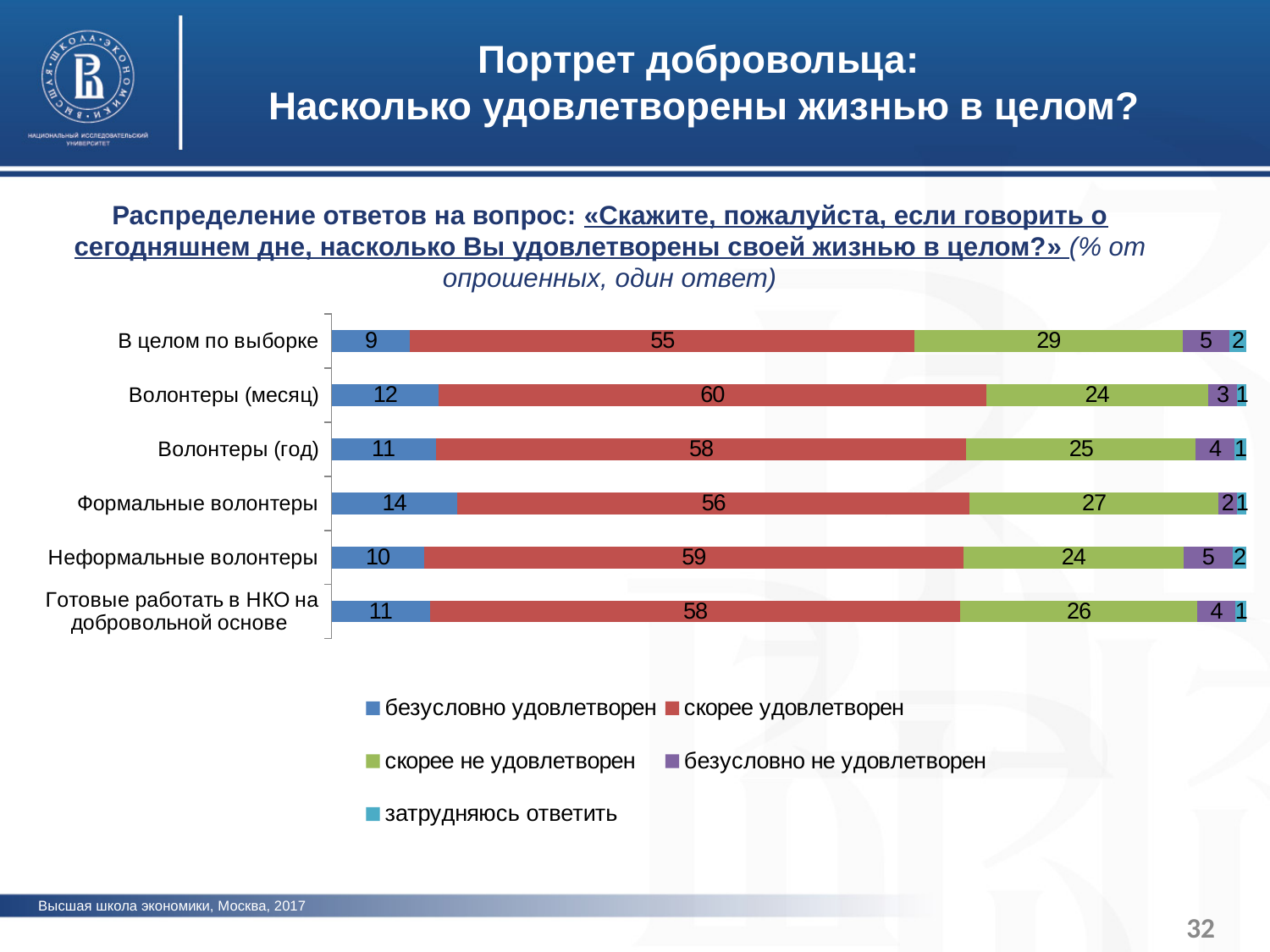
What is the value of «скорее не удовлетворен» for «В целом по выборке»? 29 Which is larger: the «скорее не удовлетворен» value for «В целом по выборке» or for «Волонтеры (год)»? В целом по выборке What is the value of «безусловно удовлетворен» for «Формальные волонтеры»? 14 What is the value of «безусловно не удовлетворен» for «Неформальные волонтеры»? 5 What kind of chart is shown on the slide? Stacked bar chart What is the total of the stacked bar for «Готовые работать в НКО на добровольной основе»? 100 How many categories (rows) are shown in the chart? 6 How many series does the legend list? 5 Which category has the highest value for «безусловно удовлетворен»? Формальные волонтеры What is the difference between the «скорее удовлетворен» values for «Волонтеры (месяц)» and «В целом по выборке»? 5 Which category has the lowest value for «безусловно удовлетворен»? В целом по выборке What is the value of «скорее удовлетворен» for «Волонтеры (месяц)»? 60